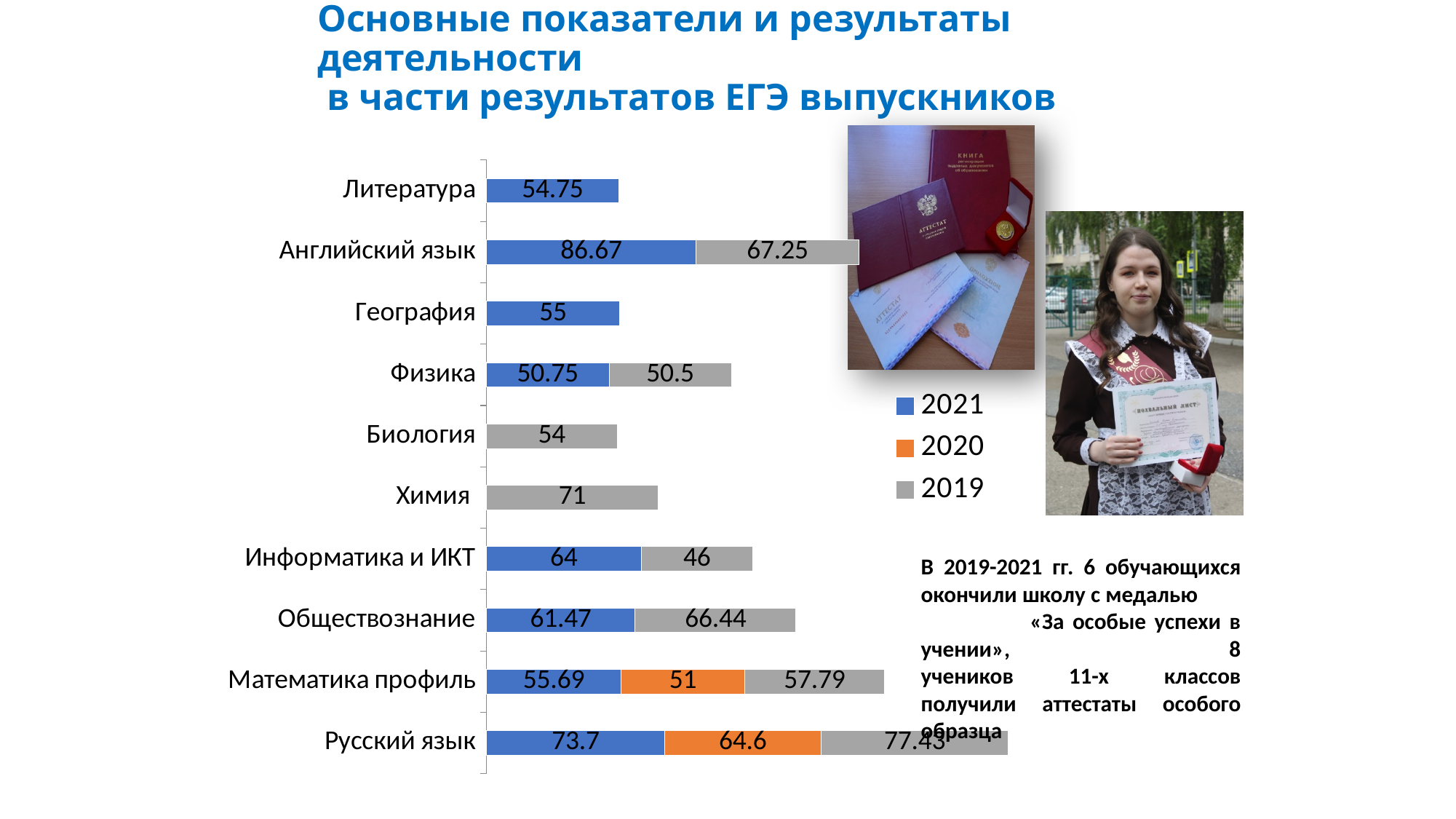
What is the 2021 value for Английский язык? 86.67 What is the difference between the 2021 and 2019 values for Информатика и ИКТ? 18 What is the 2019 value for Химия? 71 How many series does the legend list? 3 Which subject has the highest 2021 value? Английский язык What is the 2020 value for Математика профиль? 51 Which subject has the lowest 2021 value? Физика What kind of chart is shown on the slide? Stacked bar chart For Обществознание, which year has the larger value, 2021 or 2019? 2019 What is the total of the stacked bar for Математика профиль? 164.48 What is the 2019 value for Биология? 54 How many subjects are shown on the chart? 10